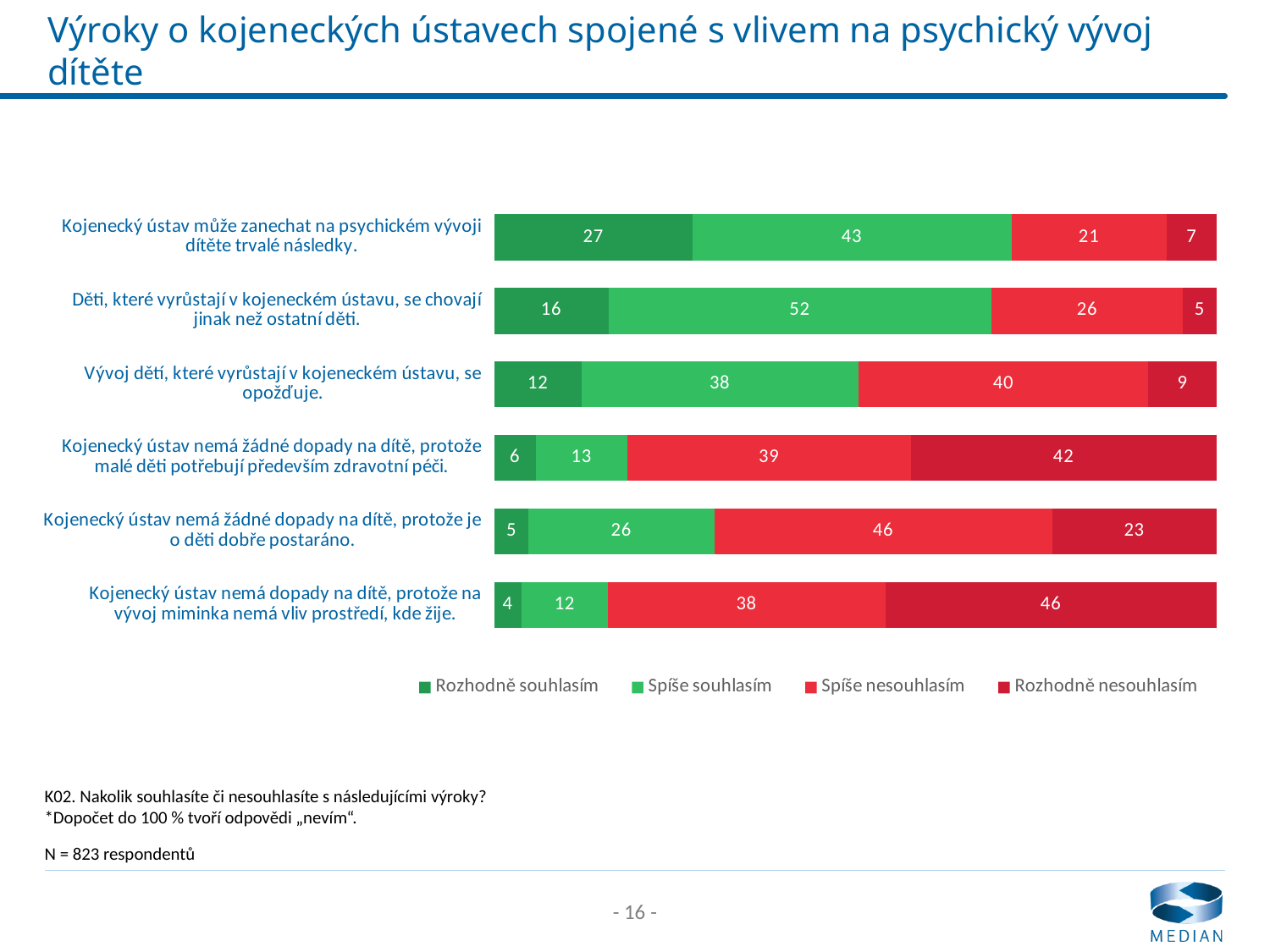
What is the value of "Rozhodně nesouhlasím" for the statement "Kojenecký ústav nemá dopady na dítě, protože na vývoj miminka nemá vliv prostředí, kde žije."? 46 For the statement "Vývoj dětí, které vyrůstají v kojeneckém ústavu, se opožďuje.", what is the difference between "Spíše nesouhlasím" and "Rozhodně nesouhlasím"? 31 Which statement has the lowest value for "Rozhodně souhlasím"? Kojenecký ústav nemá dopady na dítě, protože na vývoj miminka nemá vliv prostředí, kde žije. What is the value of "Spíše nesouhlasím" for the statement "Kojenecký ústav nemá žádné dopady na dítě, protože je o děti dobře postaráno."? 46 What is the value of "Rozhodně souhlasím" for the statement "Kojenecký ústav může zanechat na psychickém vývoji dítěte trvalé následky."? 27 How many series does the legend list? 4 Which statement has the highest value for "Rozhodně souhlasím"? Kojenecký ústav může zanechat na psychickém vývoji dítěte trvalé následky. How many statements are shown in the chart? 6 Which statement has a larger "Spíše souhlasím" value: "Děti, které vyrůstají v kojeneckém ústavu, se chovají jinak než ostatní děti." or "Vývoj dětí, které vyrůstají v kojeneckém ústavu, se opožďuje."? Děti, které vyrůstají v kojeneckém ústavu, se chovají jinak než ostatní děti. What is the value of "Spíše souhlasím" for the statement "Děti, které vyrůstají v kojeneckém ústavu, se chovají jinak než ostatní děti."? 52 What is the total of the stacked bar for the statement "Kojenecký ústav nemá žádné dopady na dítě, protože malé děti potřebují především zdravotní péči."? 100 What kind of chart is shown on the slide? Stacked bar chart